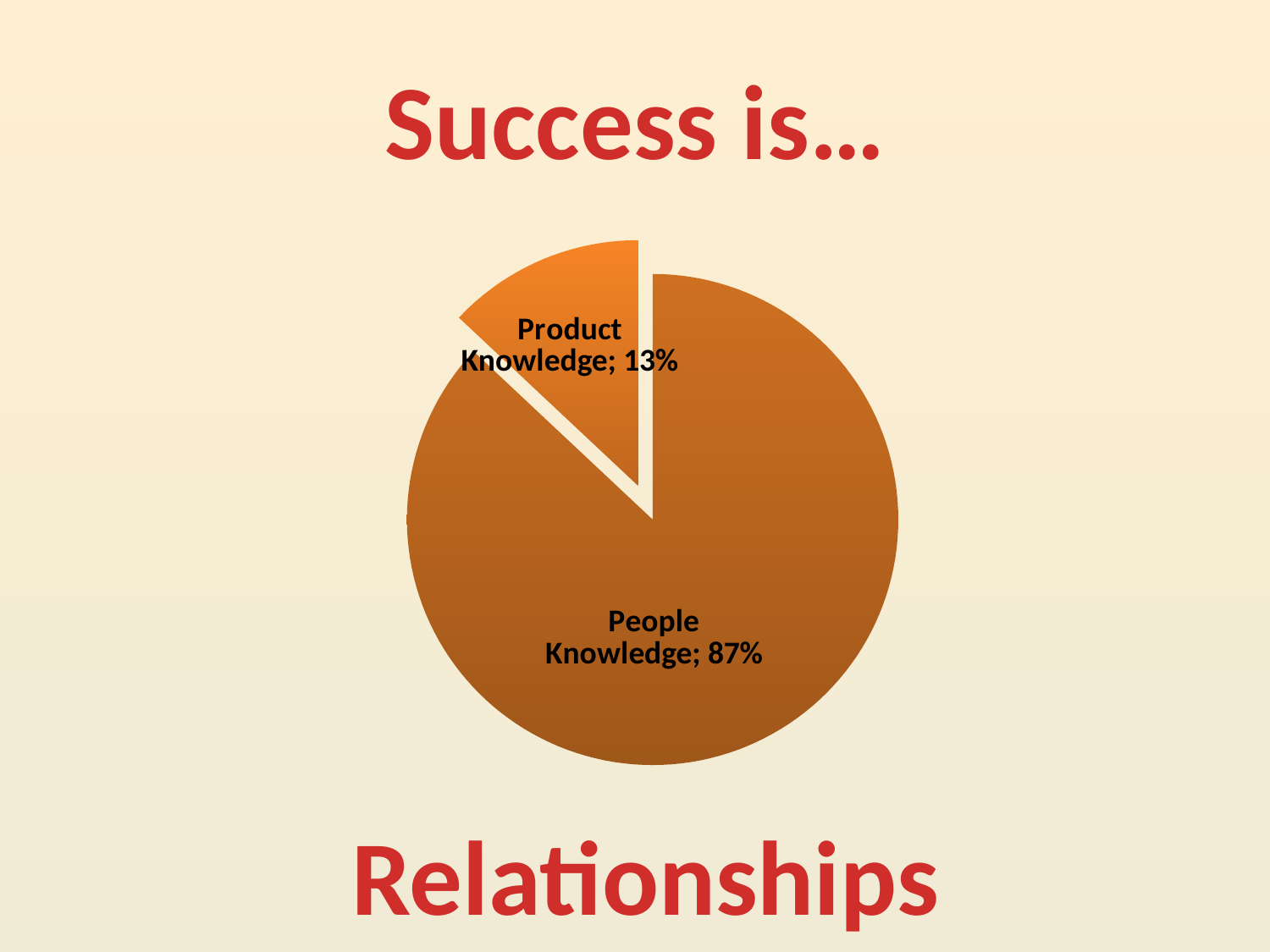
What is the title text above the chart? Success is… Which slice is the largest? People Knowledge Which slice is the smallest? Product Knowledge What kind of chart is shown on the slide? pie chart Which is larger, Product Knowledge or People Knowledge? People Knowledge What is the value for People Knowledge? 87% What is the total of the two slices shown? 100% How many slices does the pie chart have? 2 What is the difference between People Knowledge and Product Knowledge? 74% What is the value for Product Knowledge? 13% Which slice is pulled out from the rest of the pie? Product Knowledge What share of the pie does People Knowledge take? 87%